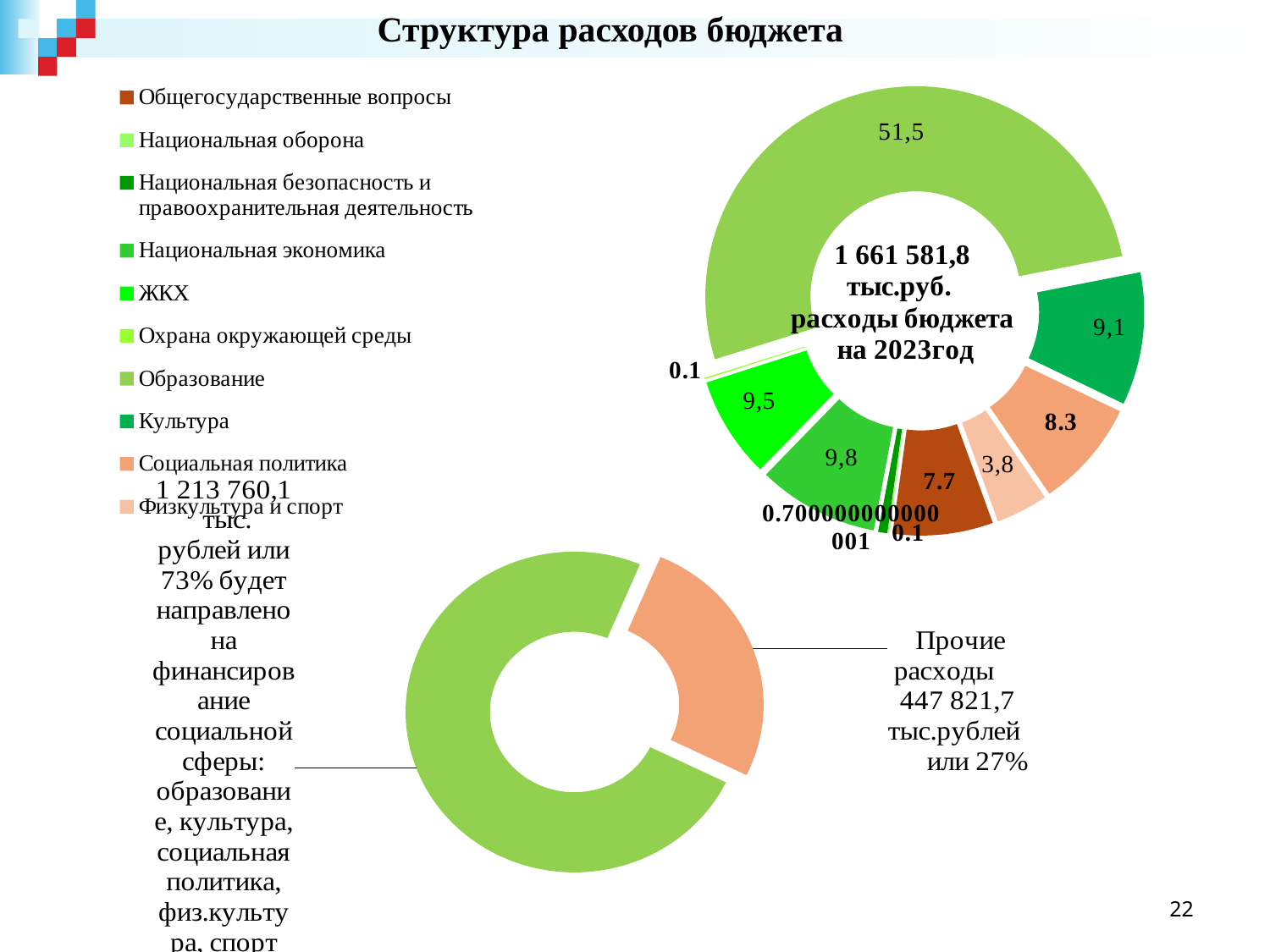
In the top-right chart, what is the value for Общегосударственные вопросы? 7.7 In the top-right chart, what is the value for Физкультура и спорт? 3,8 What total amount is written in the centre of the top-right chart? 1 661 581,8 тыс.руб. In the top-right chart, what is the value for Культура? 9,1 In the top-right chart, which is larger: ЖКХ or Национальная экономика? Национальная экономика In the top-right chart, what is the difference between the values for Образование and Культура? 42,4 In the top-right chart, what is the value for Образование? 51,5 What kind of chart is the top-right chart on the slide? pie (doughnut) chart How many categories does the legend of the top-right chart list? 10 In the bottom chart, what share of the budget goes to Прочие расходы? 27% In the top-right chart, which category has the largest slice? Образование In the top-right chart, what is the value for Социальная политика? 8.3